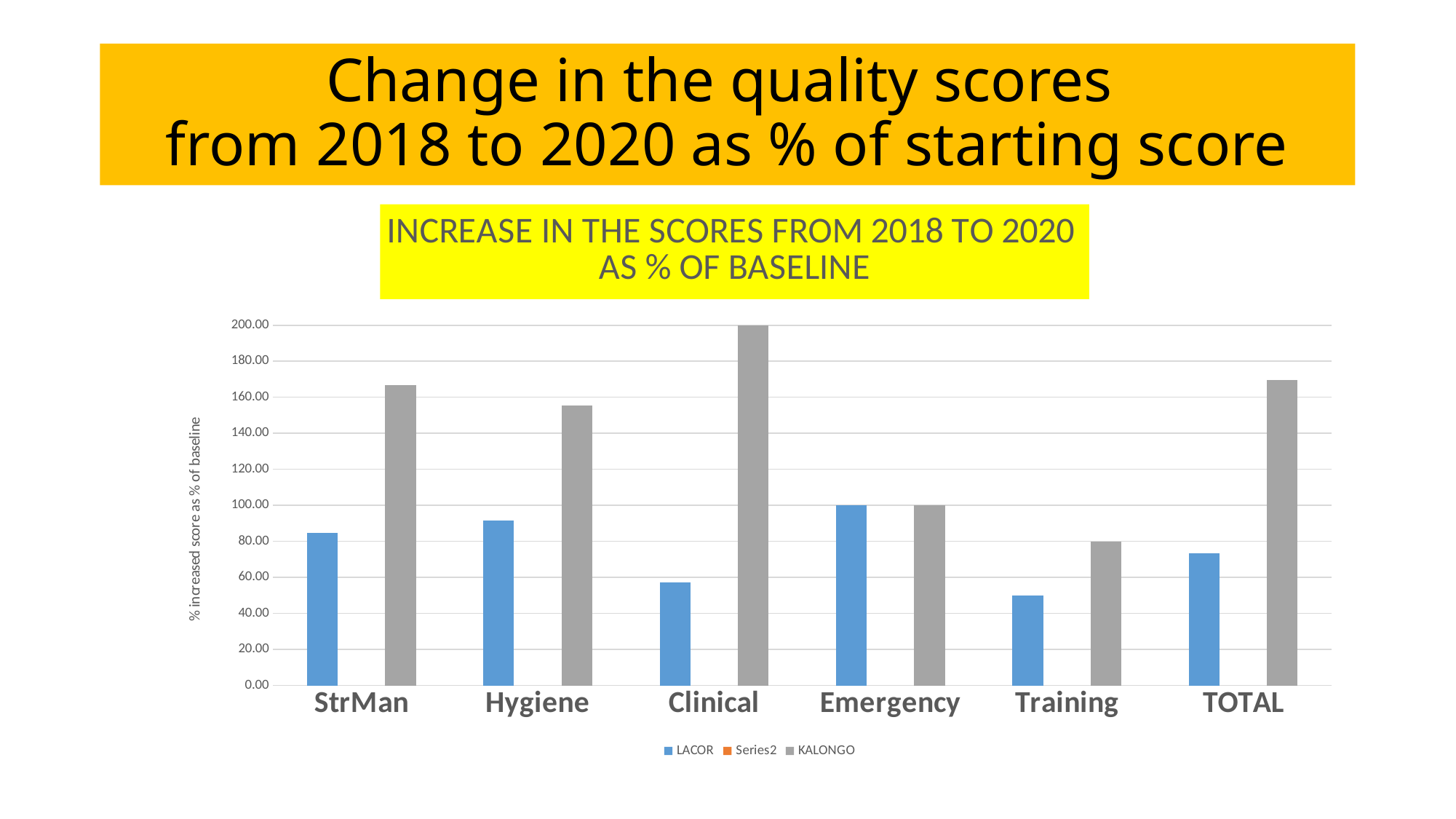
Which category has the lowest LACOR value? Training Is the LACOR value for Hygiene greater or less than 80.00? greater What is the KALONGO value for Clinical? 200.00 For StrMan, which is larger: the LACOR value or the KALONGO value? KALONGO Which category has the highest KALONGO value? Clinical What is the KALONGO value for Training? 80.00 What is the LACOR value for Emergency? 100.00 What kind of chart is shown on the slide? bar chart How many categories are shown on the x axis of the chart? 6 How many series does the chart's legend list? 3 What is the label of the vertical axis of the chart? % increased score as % of baseline Which category has the lowest KALONGO value? Training